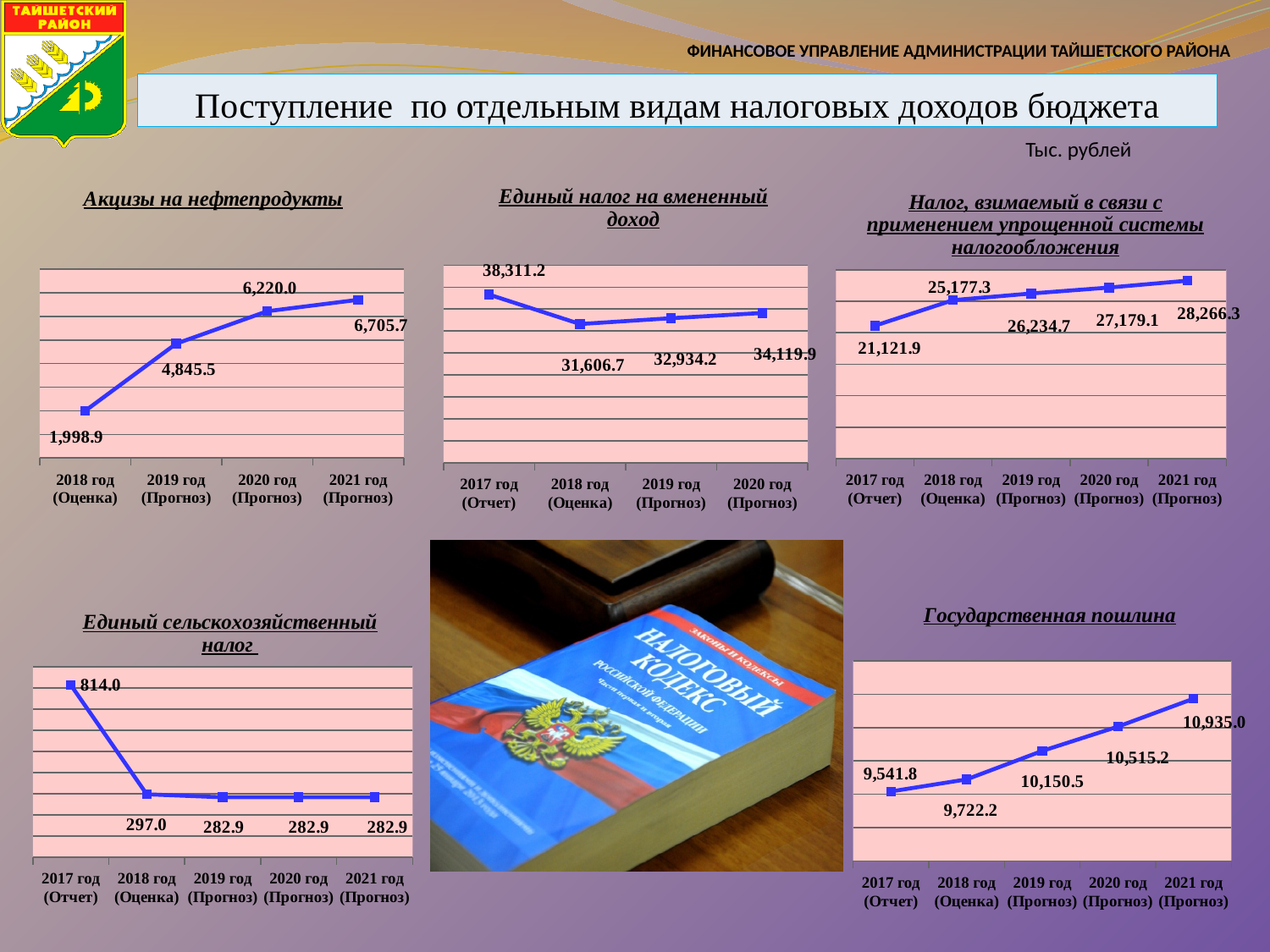
What type of chart is the chart titled "Государственная пошлина"? line chart In the chart titled "Государственная пошлина", which is larger: the value for 2018 год (Оценка) or the value for 2019 год (Прогноз)? 2019 год (Прогноз) In the chart titled "Единый сельскохозяйственный налог", what is the value for 2017 год (Отчет)? 814.0 In the chart titled "Единый сельскохозяйственный налог", which year has the highest value? 2017 год (Отчет) In the chart titled "Налог, взимаемый в связи с применением упрощенной системы налогообложения", do the values rise or fall from 2017 to 2021? rise In the chart titled "Акцизы на нефтепродукты", what is the value for 2021 год (Прогноз)? 6,705.7 In the chart titled "Единый налог на вмененный доход", what is the value for 2017 год (Отчет)? 38,311.2 In the chart titled "Государственная пошлина", what is the difference between the 2021 год (Прогноз) value and the 2017 год (Отчет) value? 1,393.2 In the chart titled "Единый налог на вмененный доход", how many data points are plotted? 4 In the chart titled "Единый налог на вмененный доход", what is the difference between the 2017 год (Отчет) value and the 2018 год (Оценка) value? 6,704.5 In the chart titled "Налог, взимаемый в связи с применением упрощенной системы налогообложения", what is the value for 2019 год (Прогноз)? 26,234.7 In the chart titled "Акцизы на нефтепродукты", which year has the lowest value? 2018 год (Оценка)